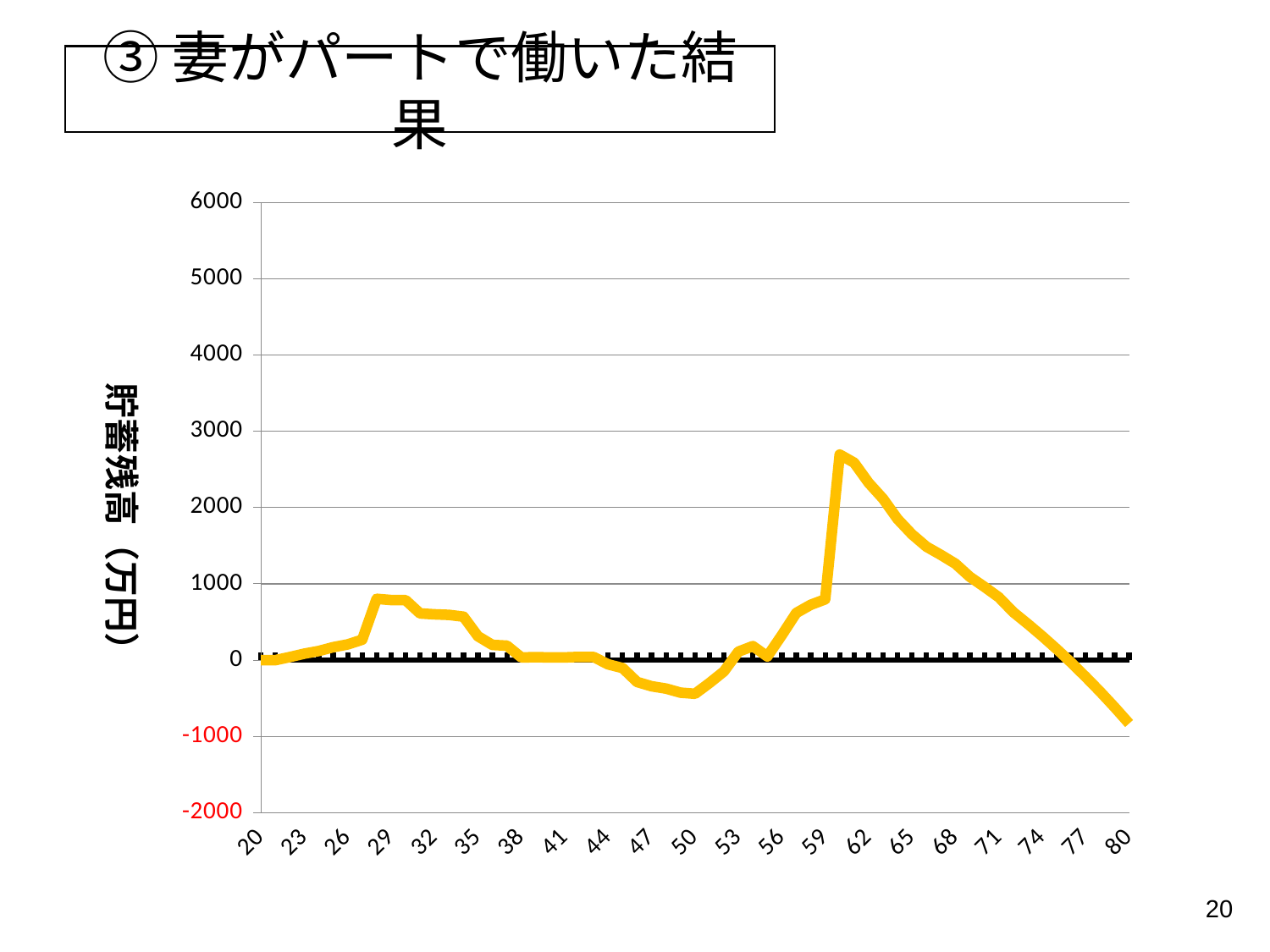
What is the label of the vertical axis? 貯蓄残高（万円） Is the value at age 62 greater or less than 2000? greater Is the value at age 80 greater or less than 0? less Do the values rise or fall from age 62 to age 80? fall How many age labels are shown along the x axis? 21 Is the value at age 50 greater or less than 0? less What kind of chart is shown on the slide? line chart Which is larger, the value at age 62 or the value at age 29? age 62 What is the title of the chart on the slide? ③ 妻がパートで働いた結果